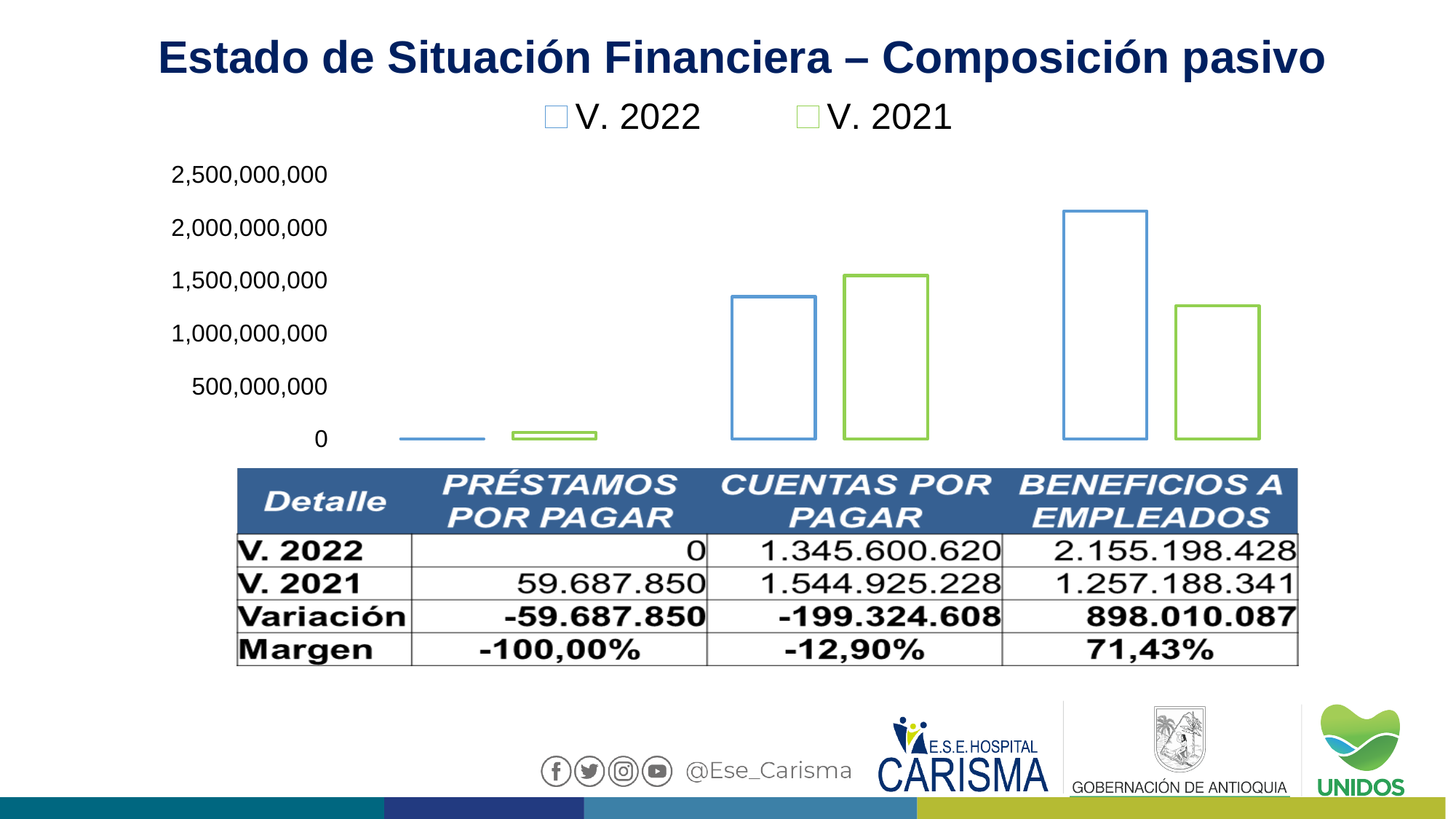
Which category has the lowest V. 2021 value? Préstamos por pagar Which category has the highest V. 2022 value? Beneficios a empleados For Cuentas por pagar, which is larger: the V. 2022 value or the V. 2021 value? V. 2021 What is the difference between the V. 2022 and V. 2021 values for Beneficios a empleados? 898.010.087 What is the title of the slide containing the chart? Estado de Situación Financiera – Composición pasivo How many categories are plotted on the chart? 3 Is the V. 2022 value for Beneficios a empleados greater or less than 2,000,000,000? greater What is the V. 2021 value for Beneficios a empleados? 1.257.188.341 What kind of chart is shown on the slide? Bar chart How many series does the chart legend list? 2 What is the V. 2021 value for Préstamos por pagar? 59.687.850 What is the V. 2022 value for Cuentas por pagar? 1.345.600.620